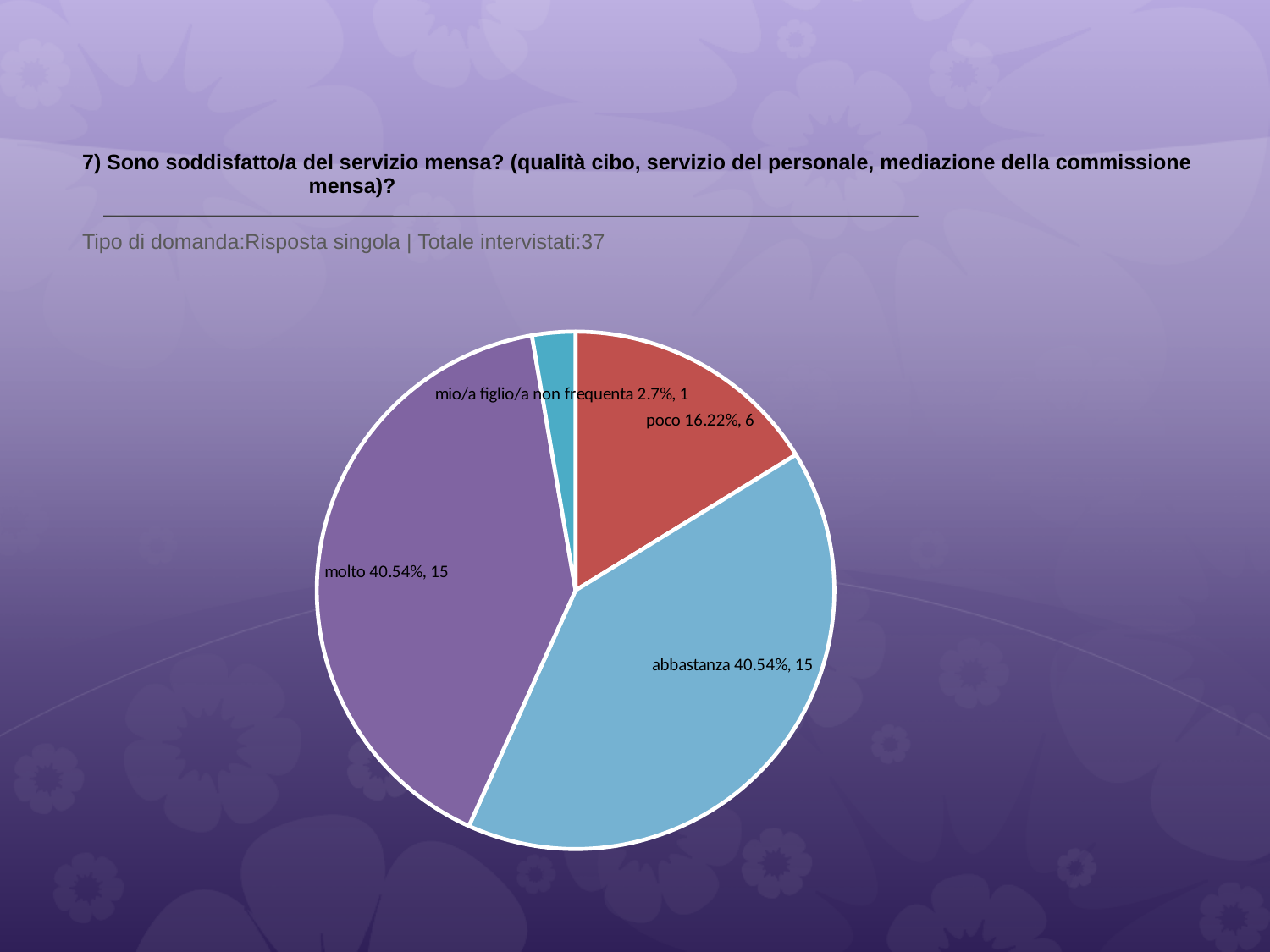
What is the total number of respondents shown in the pie chart? 37 What is the difference in number of respondents between "abbastanza" and "poco"? 9 How many slices does the pie chart have? 4 Which is larger, the "poco" slice or the "abbastanza" slice? abbastanza What kind of chart is shown on the slide? pie chart What is the difference in percentage between "poco" and "mio/a figlio/a non frequenta"? 13.52% What percentage share does the "molto" slice have? 40.54% What percentage of respondents answered "poco"? 16.22% What colour is the "poco" slice of the pie chart? red How many respondents answered "abbastanza"? 15 How many respondents answered "mio/a figlio/a non frequenta"? 1 Which category has the smallest slice of the pie? mio/a figlio/a non frequenta